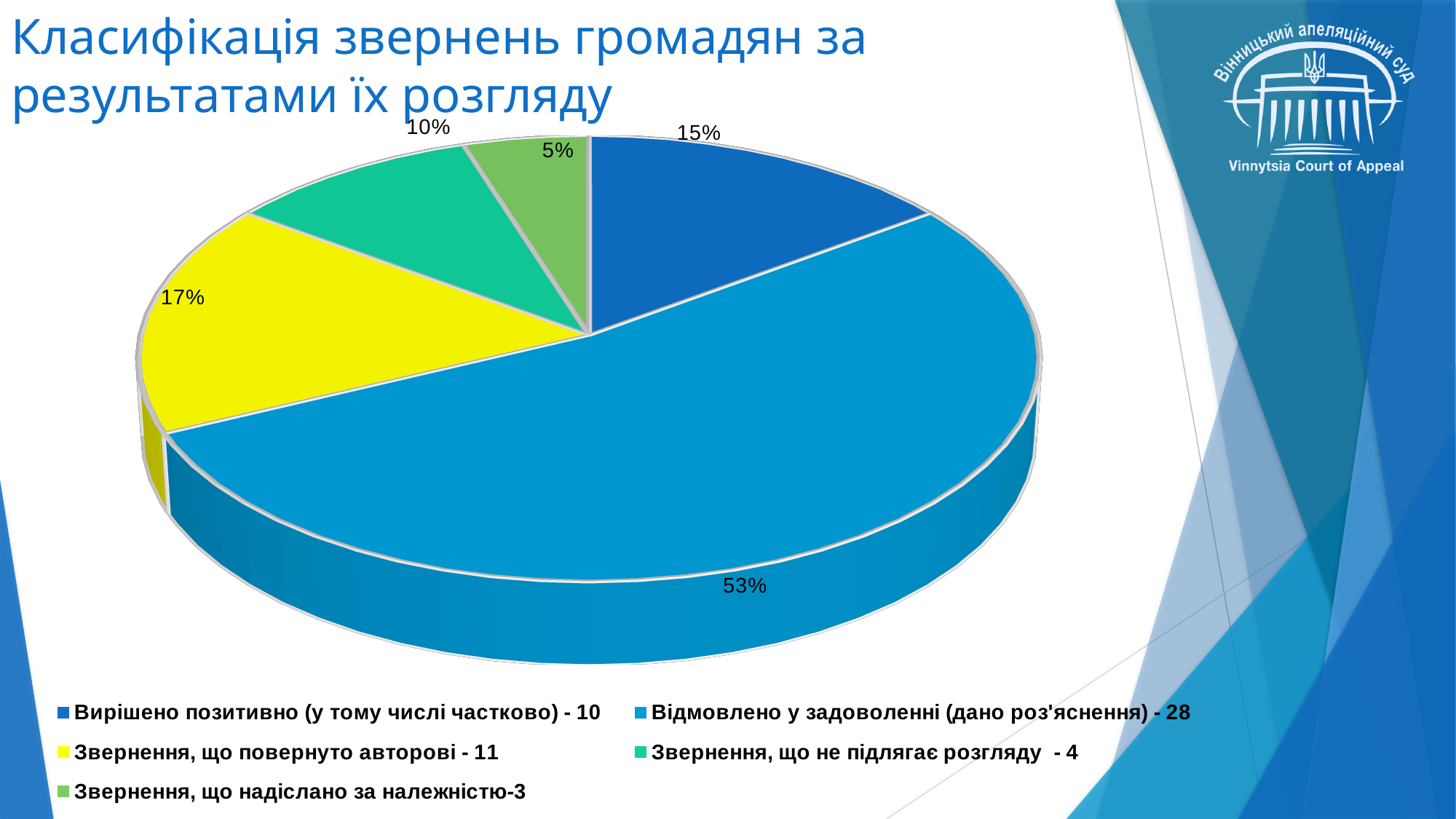
What percentage share does the slice "Вирішено позитивно (у тому числі частково) - 10" have? 15% Which category has the largest slice of the pie? Відмовлено у задоволенні (дано роз'яснення) - 28 What percentage share does the slice "Відмовлено у задоволенні (дано роз'яснення) - 28" have? 53% What percentage share does the slice "Звернення, що надіслано за належністю-3" have? 5% What kind of chart is shown on the slide? pie chart What is the difference in percentage points between the 53% slice and the 17% slice? 36 Which category has the smallest slice of the pie? Звернення, що надіслано за належністю-3 How many slices does the pie chart have? 5 Which slice is larger: "Вирішено позитивно (у тому числі частково) - 10" or "Звернення, що повернуто авторові - 11"? Звернення, що повернуто авторові - 11 What colour is the slice for "Звернення, що повернуто авторові - 11"? yellow